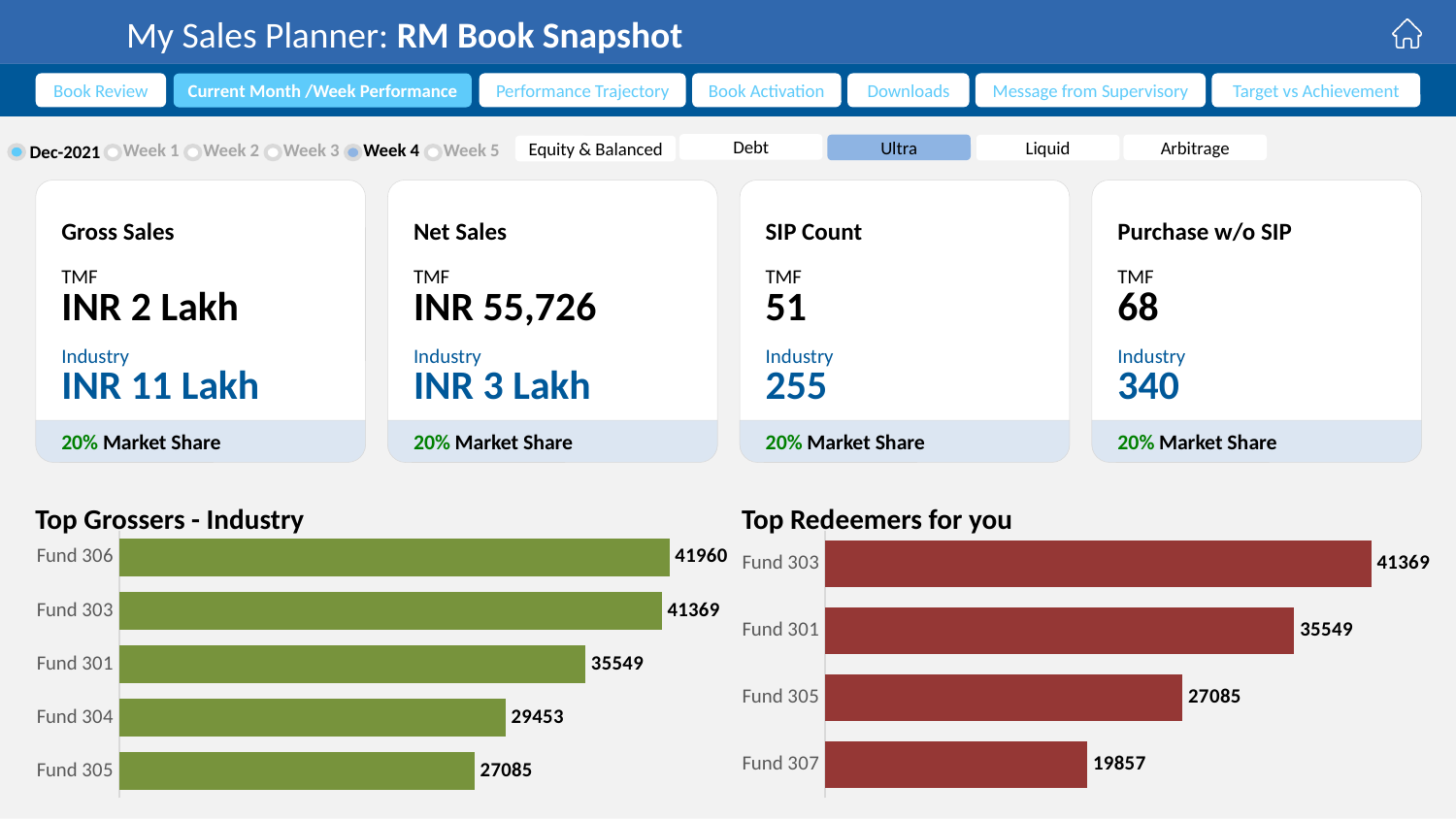
In the Top Grossers - Industry chart, how many funds are shown? 5 In the Top Grossers - Industry chart, what is the value for Fund 304? 29453 In the Top Grossers - Industry chart, which fund has the lowest value? Fund 305 In the Top Redeemers for you chart, which fund has the highest value? Fund 303 In the Top Redeemers for you chart, what is the difference between Fund 303 and Fund 301? 5820 In the Top Grossers - Industry chart, what is the value for Fund 306? 41960 In the Top Grossers - Industry chart, what is the difference between Fund 306 and Fund 305? 14875 In the Top Redeemers for you chart, what is the value for Fund 307? 19857 In the Top Redeemers for you chart, how many funds are shown? 4 What colour are the bars in the Top Redeemers for you chart? Red What kind of chart is the Top Grossers - Industry chart? Bar chart In the Top Redeemers for you chart, which is larger, Fund 301 or Fund 305? Fund 301